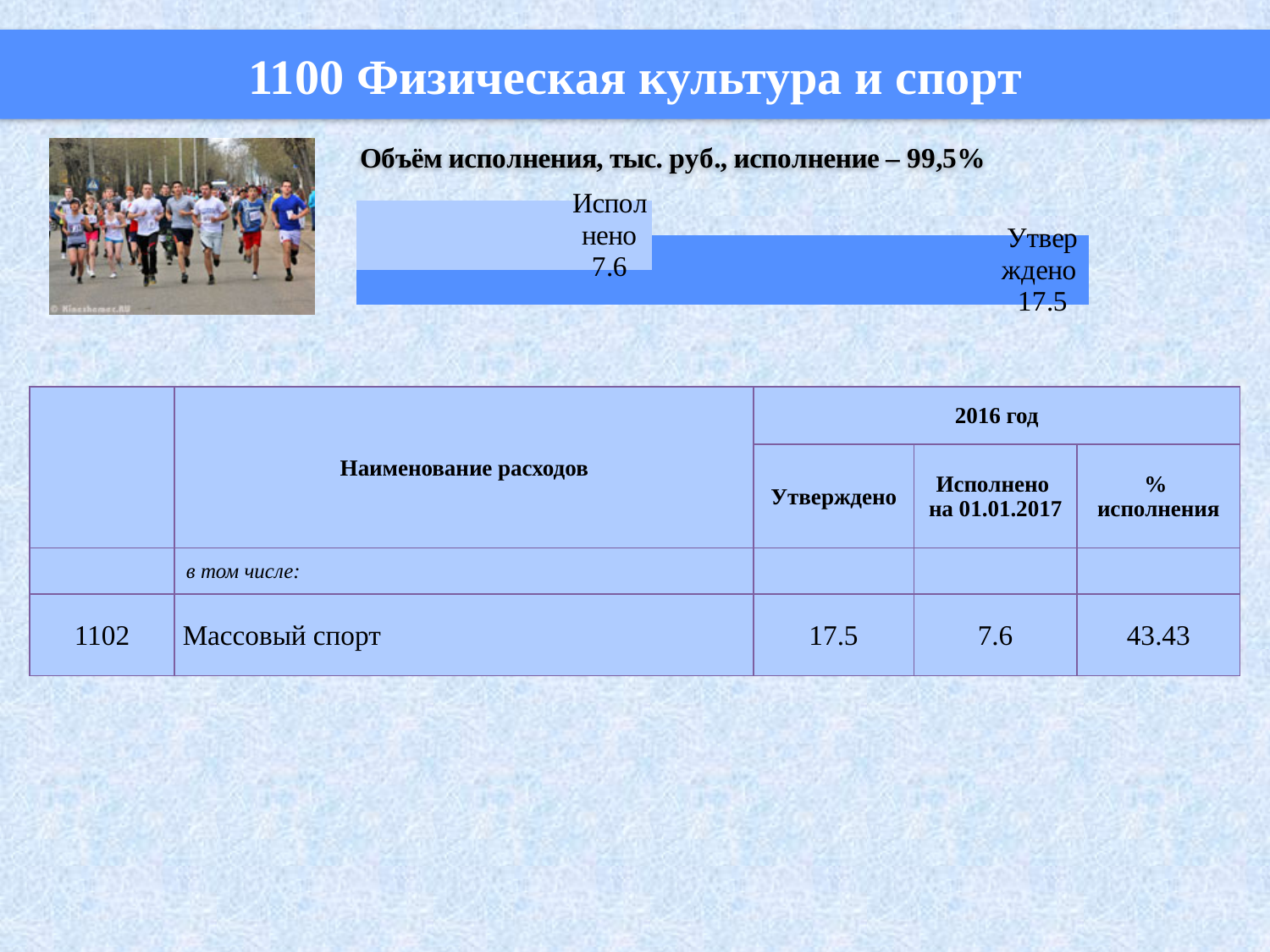
What is the title of the chart? Объём исполнения, тыс. руб., исполнение – 99,5% What is the value of the "Утверждено" bar in the chart? 17.5 Which bar in the chart is drawn in the lighter blue colour? Исполнено What is the value of the "Исполнено" bar in the chart? 7.6 What is the difference between the "Утверждено" and "Исполнено" values in the chart? 9.9 How many bars are plotted in the chart? 2 Which bar in the chart has the lower value? Исполнено Which bar in the chart has the higher value? Утверждено Is the "Утверждено" value larger or smaller than the "Исполнено" value in the chart? larger What type of chart is shown on the slide? bar chart